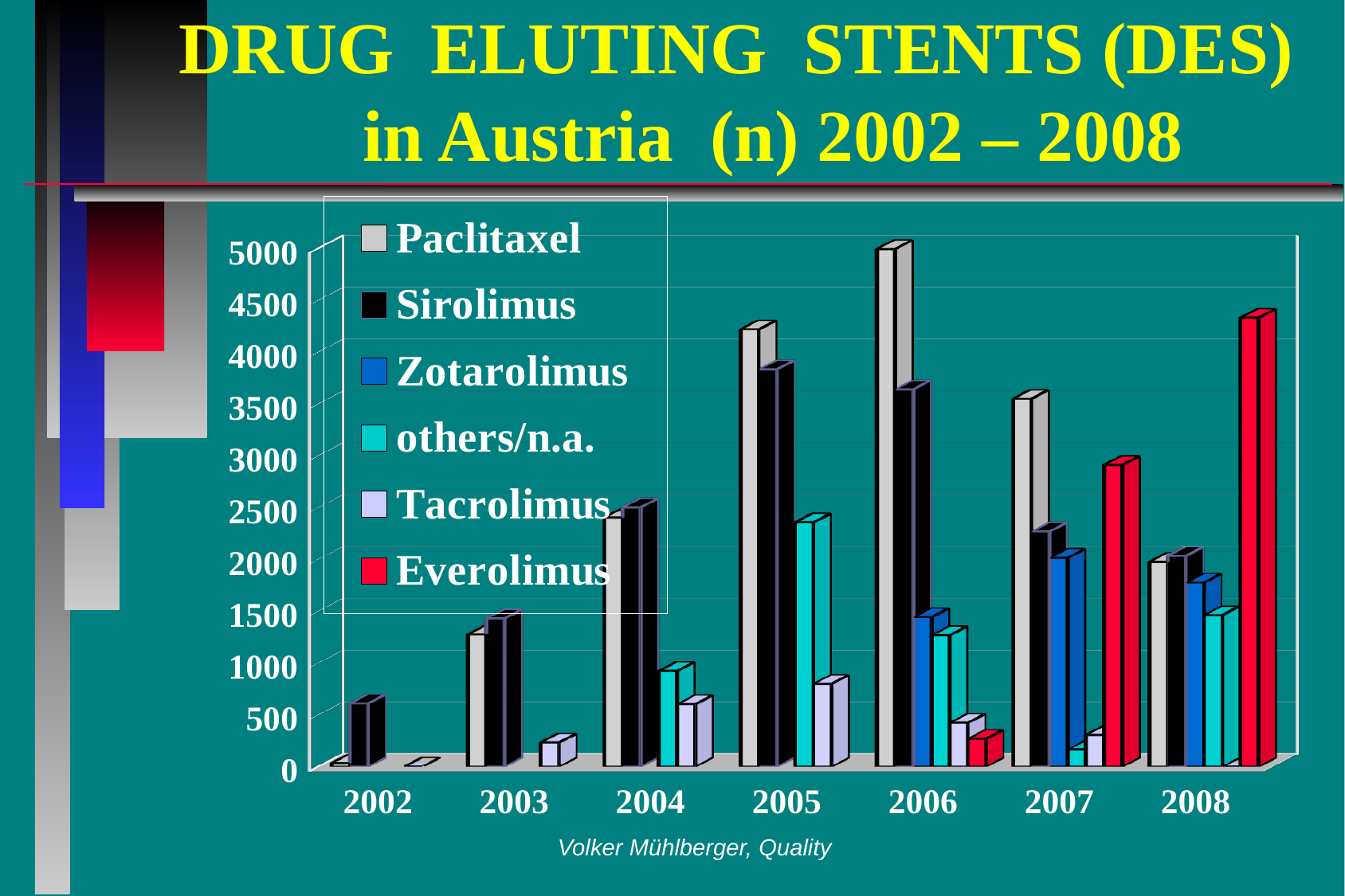
How many series does the legend list? 6 Is the value for Paclitaxel in 2006 greater or less than 4500? greater In which year does Paclitaxel reach its highest value? 2006 Which series has the lowest value in 2004? Tacrolimus How many years are shown on the x axis of the chart? 7 Which series has the highest value in 2008? Everolimus What kind of chart is shown on the slide? bar chart Is the value for Everolimus in 2006 greater or less than 500? less Which is larger: Paclitaxel in 2006 or Everolimus in 2008? Paclitaxel in 2006 Does the value for Everolimus rise or fall from 2006 to 2008? rise Which series has the highest value in 2005? Paclitaxel Is the value for Everolimus in 2008 greater or less than 4000? greater